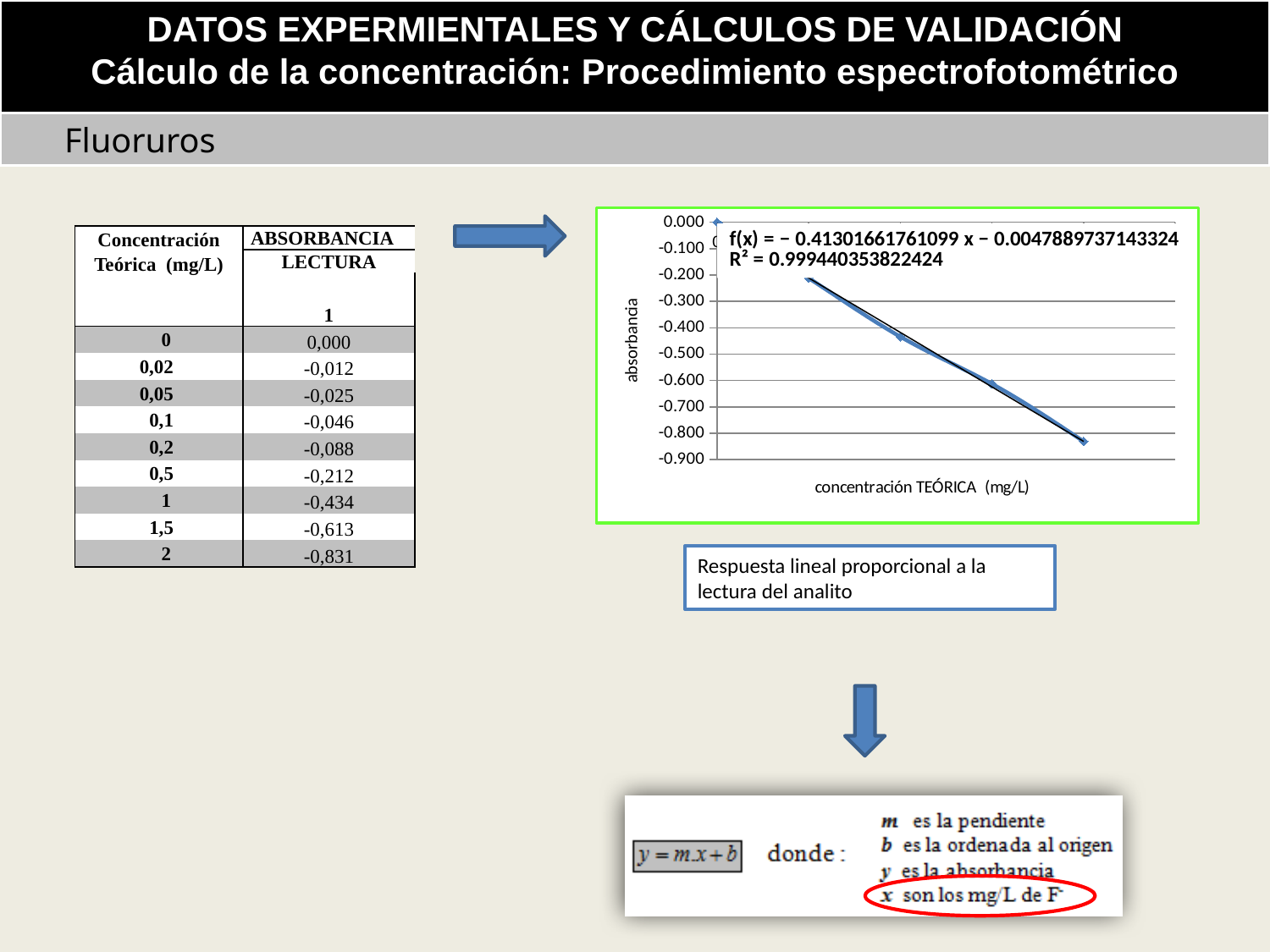
What is the slope (coefficient of x) in the equation printed on the chart? −0.41301661761099 What is the title of the vertical axis of the chart? absorbancia What is the R² value printed on the chart? R² = 0.999440353822424 What is the title of the horizontal axis of the chart? concentración TEÓRICA (mg/L) Is the absorbance of the leftmost (lowest concentration) point greater or less than -0.100? greater As the theoretical concentration increases along the x axis, do the absorbance values rise or fall? fall Is the slope of the fitted line on the chart positive or negative? negative Is the absorbance of the rightmost (highest concentration) point greater or less than -0.800? less What is the intercept in the equation f(x) printed on the chart? −0.0047889737143324 What kind of chart is shown on the slide? scatter chart with a linear trendline